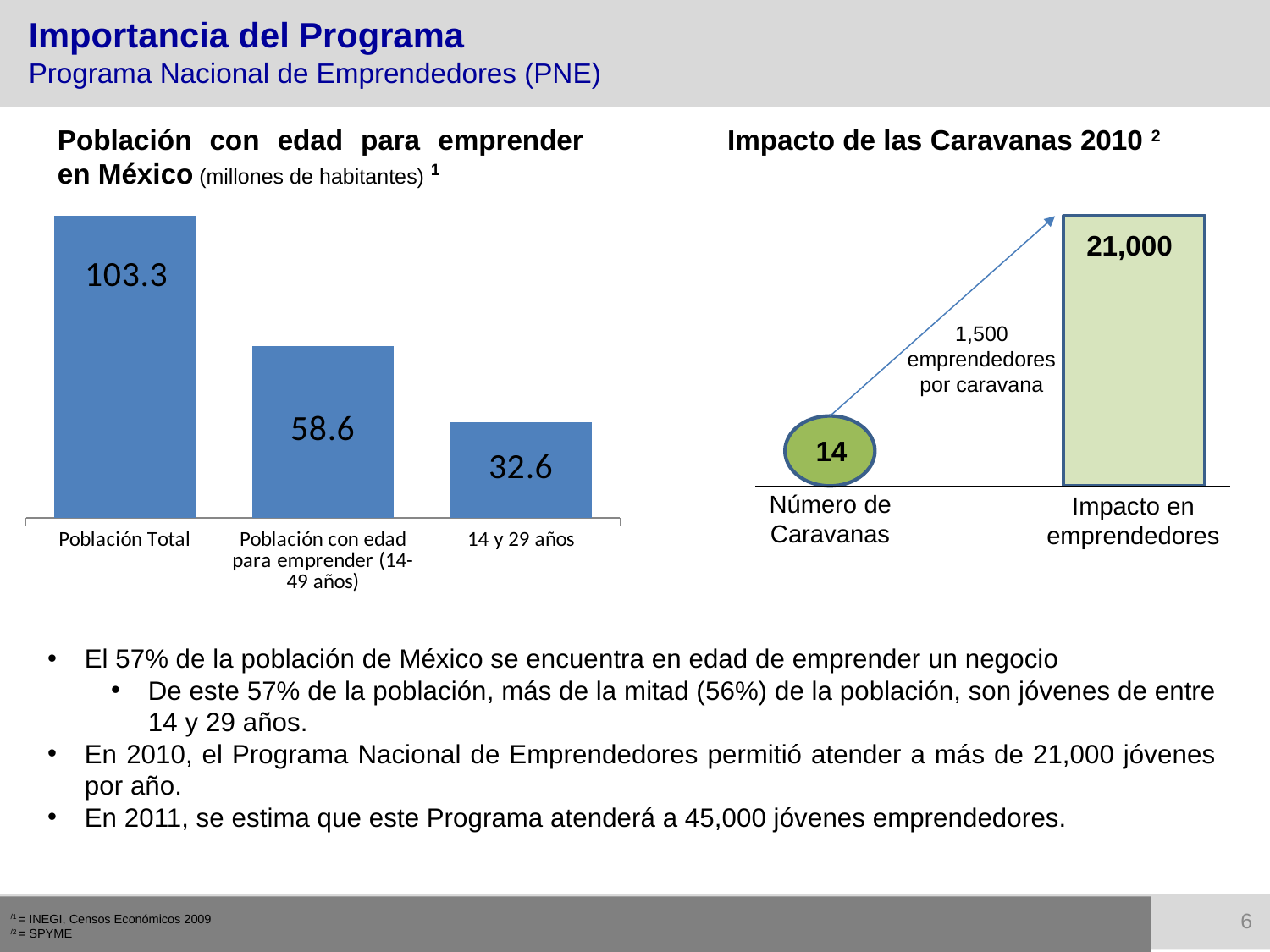
In the chart 'Población con edad para emprender en México', what is the difference between Población Total and Población con edad para emprender (14-49 años)? 44.7 In the chart 'Población con edad para emprender en México', what unit is stated in the title? millones de habitantes In the chart 'Población con edad para emprender en México', what is the value for Población Total? 103.3 In the chart 'Población con edad para emprender en México', which category has the highest value? Población Total In the chart 'Población con edad para emprender en México', what is the difference between Población con edad para emprender (14-49 años) and 14 y 29 años? 26.0 What type of chart is 'Población con edad para emprender en México'? Bar chart In the chart 'Población con edad para emprender en México', do the values rise or fall from left to right? Fall In the chart 'Población con edad para emprender en México', what is the value for 14 y 29 años? 32.6 In the chart 'Población con edad para emprender en México', which category has the lowest value? 14 y 29 años How many bars are in the chart 'Población con edad para emprender en México'? 3 In the chart 'Población con edad para emprender en México', what is the value for Población con edad para emprender (14-49 años)? 58.6 In the chart 'Población con edad para emprender en México', which is larger: Población con edad para emprender (14-49 años) or 14 y 29 años? Población con edad para emprender (14-49 años)